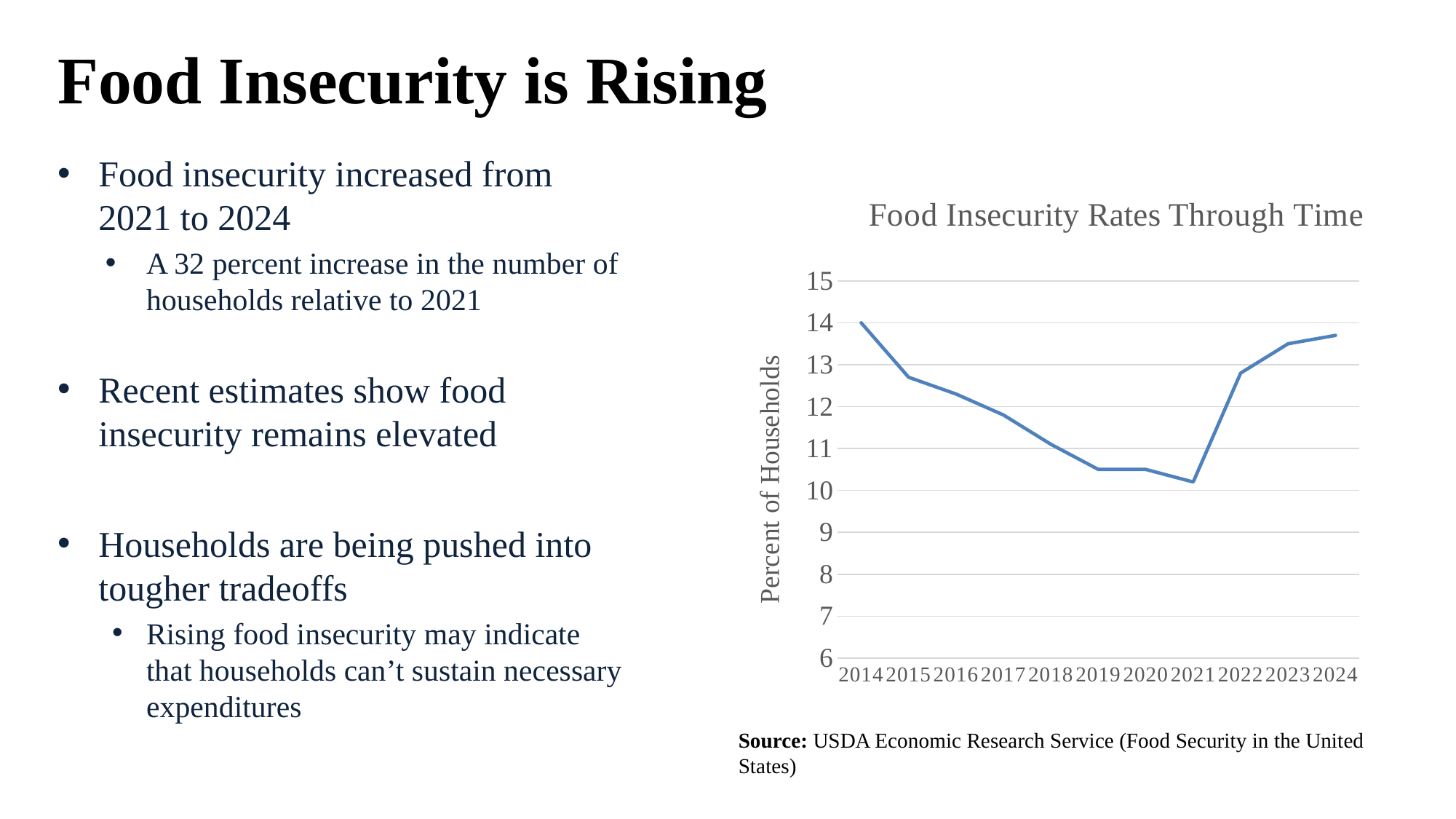
Does the food insecurity rate rise or fall from 2021 to 2024? rise What is the title of the chart? Food Insecurity Rates Through Time Is the value for 2021 greater or less than 11? less Which year has a higher food insecurity rate, 2021 or 2024? 2024 Is the value for 2024 greater or less than 13? greater Does the food insecurity rate rise or fall from 2014 to 2019? fall Which year has the highest food insecurity rate in the chart? 2014 Is the value for 2022 greater or less than 12? greater How many years are plotted on the x axis of the chart? 11 Which year has the lowest food insecurity rate in the chart? 2021 What kind of chart is shown on the slide? line chart What is the label on the vertical axis of the chart? Percent of Households